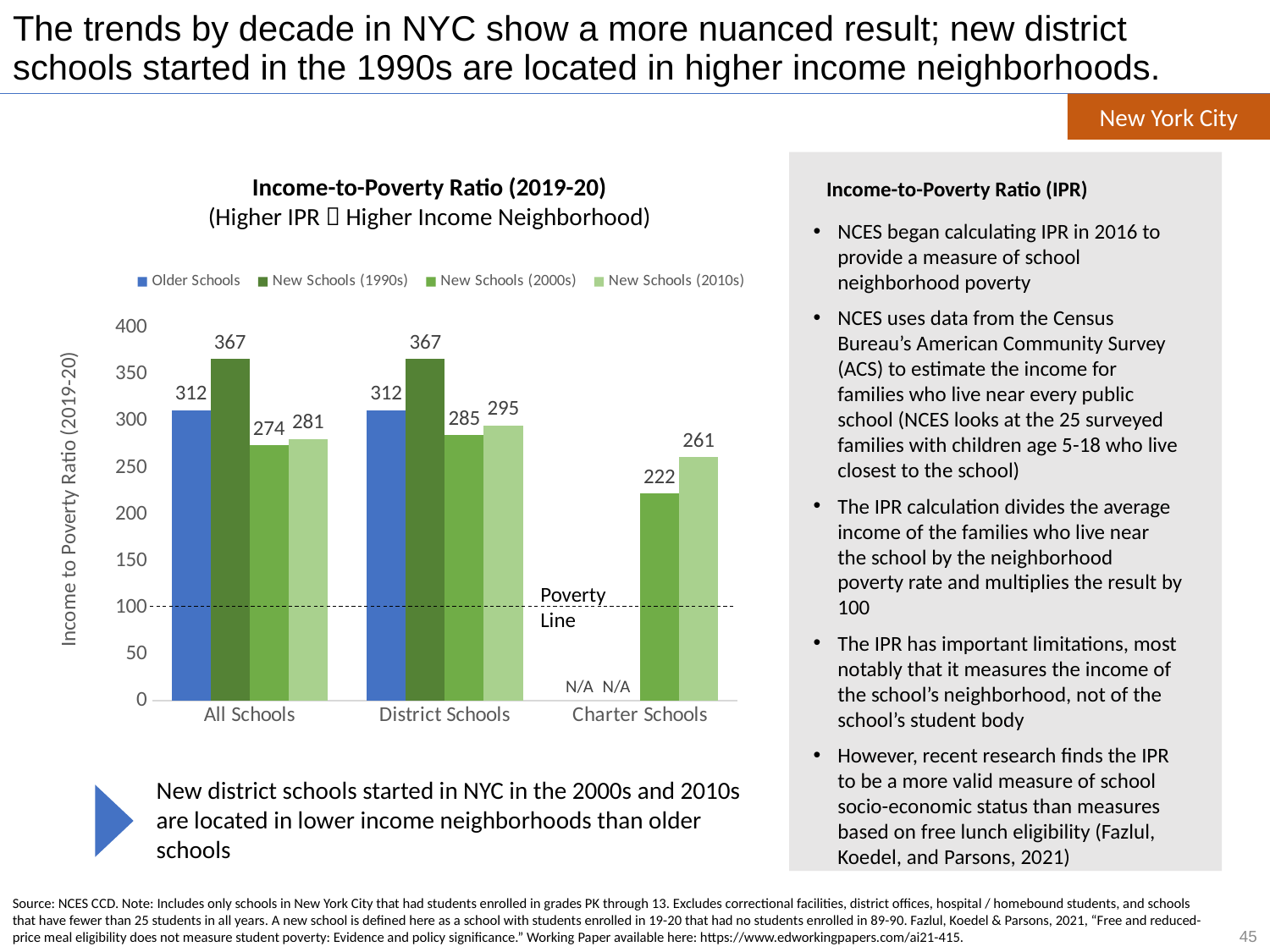
What is the Income-to-Poverty Ratio for Older Schools in the All Schools category? 312 What is the difference between the Income-to-Poverty Ratio for New Schools (1990s) and Older Schools in the All Schools category? 55 Is the Income-to-Poverty Ratio for New Schools (2000s) in the Charter Schools category greater or less than 200? greater In the Charter Schools category, which is larger: the value for New Schools (2000s) or New Schools (2010s)? New Schools (2010s) What is the Income-to-Poverty Ratio for New Schools (2010s) in the Charter Schools category? 261 How many series does the legend list? 4 Which series has the lowest Income-to-Poverty Ratio in the All Schools category? New Schools (2000s) What kind of chart is shown on the slide? Bar chart What value does the dashed horizontal line labeled Poverty Line mark on the y axis? 100 What is the Income-to-Poverty Ratio for New Schools (2000s) in the District Schools category? 285 What is the difference between the Income-to-Poverty Ratio for New Schools (2010s) and New Schools (2000s) in the Charter Schools category? 39 Which series has the highest Income-to-Poverty Ratio in the District Schools category? New Schools (1990s)